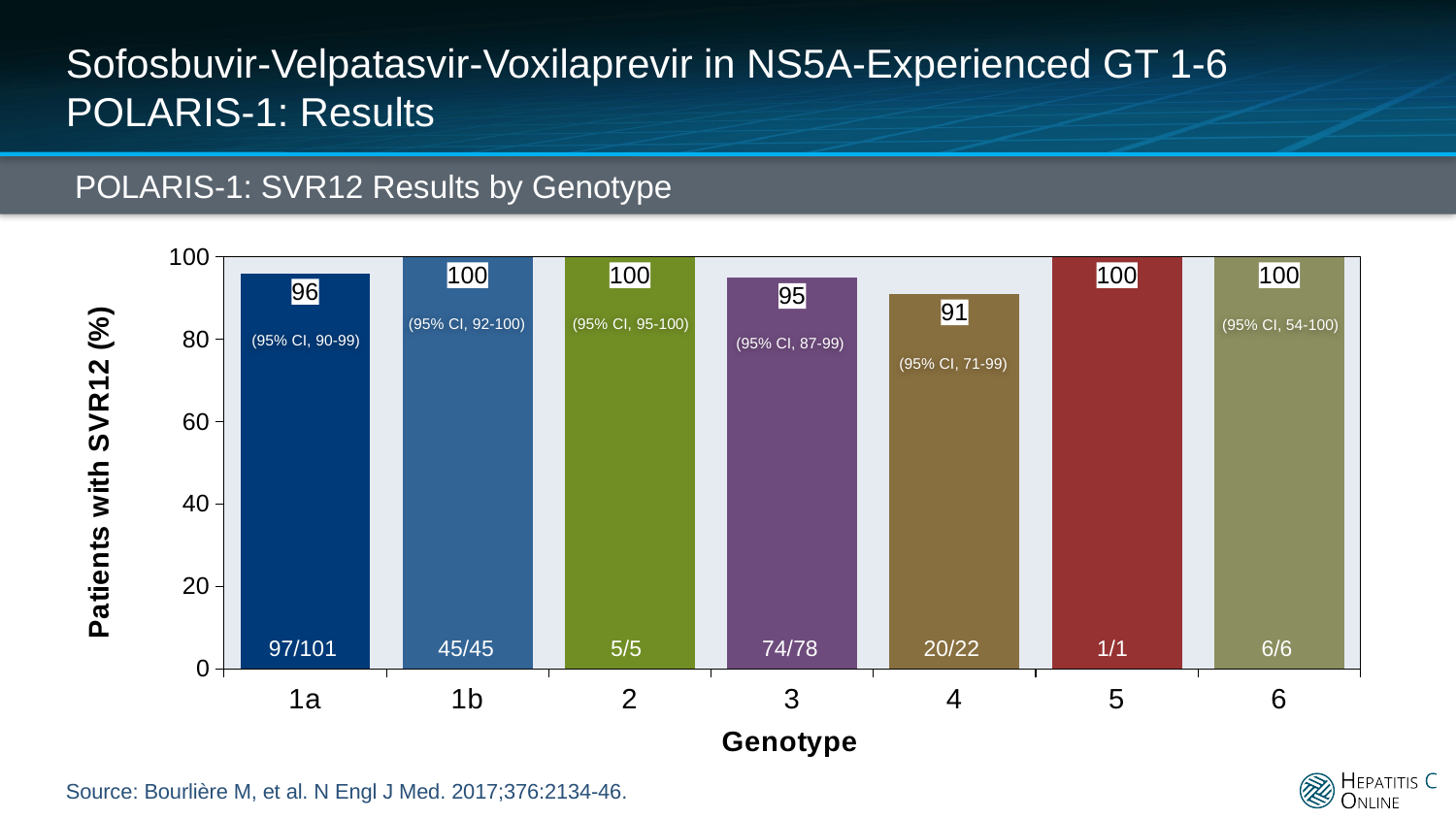
What kind of chart is shown on the slide? bar chart What is the difference in SVR12 rate between genotype 1a and genotype 3? 1 What is the SVR12 rate for genotype 3? 95 What is the SVR12 rate for genotype 1a? 96 What is the label of the y axis? Patients with SVR12 (%) How many genotype categories are shown on the x axis? 7 What is the 95% confidence interval shown for genotype 6? (95% CI, 54-100) What is the SVR12 rate for genotype 4? 91 Which has a higher SVR12 rate, genotype 1a or genotype 4? 1a What is the difference in SVR12 rate between genotype 1b and genotype 4? 9 Which genotype has the lowest SVR12 rate? 4 How many patients achieved SVR12 in genotype 3, as shown by the fraction on the bar? 74/78